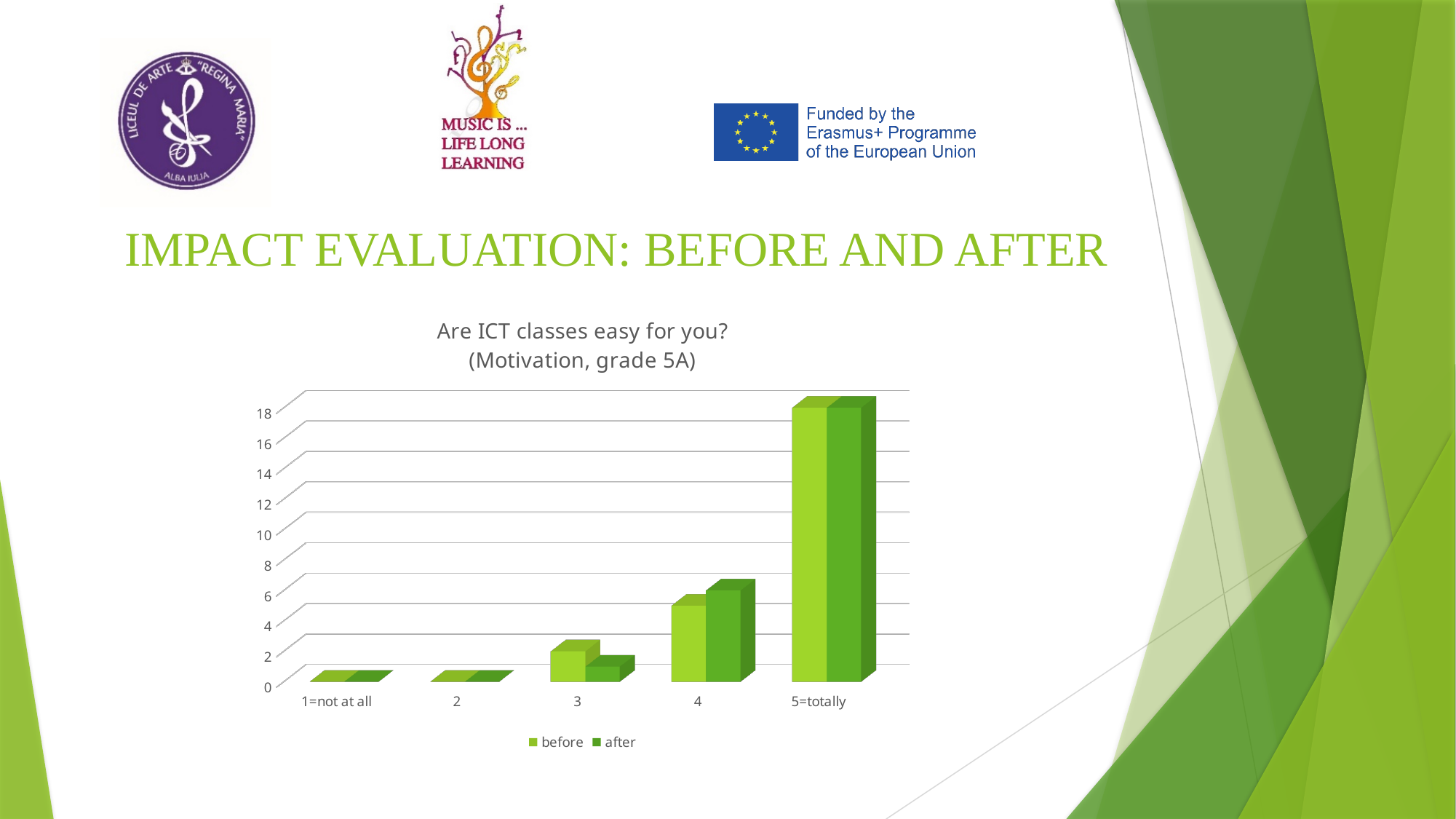
How many categories are shown on the x axis of the chart? 5 What kind of chart is shown on the slide? bar chart Is the 'before' value for 5=totally greater or less than 16? greater Which category has the highest value for the 'after' series? 5=totally For category 3, which series has the larger value, 'before' or 'after'? before Is the 'before' value for 3 greater or less than 4? less What is the title of the chart? Are ICT classes easy for you? (Motivation, grade 5A) How many series does the chart legend list? 2 Which category has the highest value for the 'before' series? 5=totally Is the 'after' value for 4 greater or less than 10? less What are the two series named in the chart legend? before and after Do the values generally rise or fall moving from 1=not at all to 5=totally along the x axis? rise